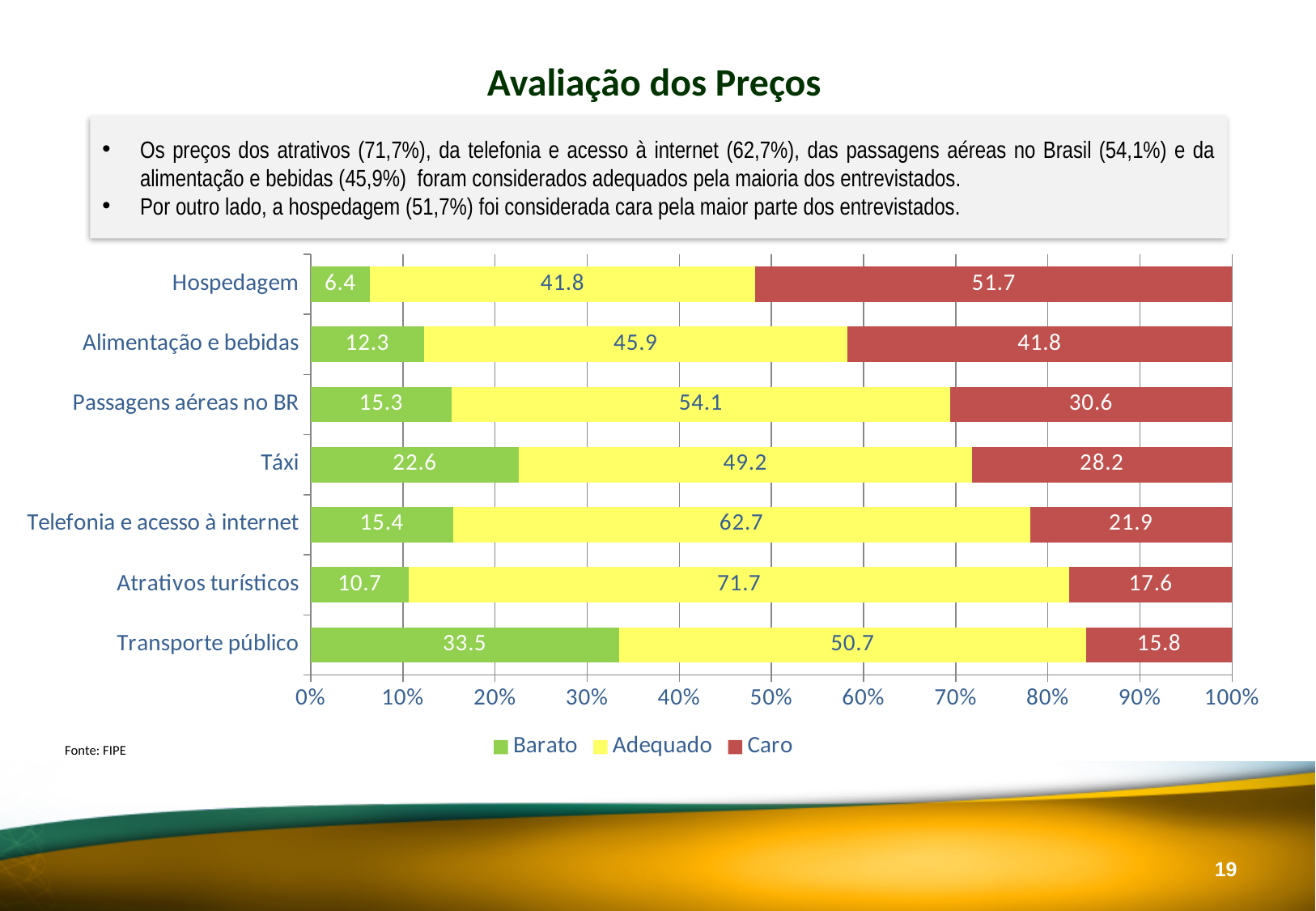
Which has the larger Barato value, Táxi or Passagens aéreas no BR? Táxi What is the value of the Barato series for Transporte público? 33.5 Which category has the lowest Barato value? Hospedagem Which category has the highest Caro value? Hospedagem Which category has the highest Adequado value? Atrativos turísticos What is the difference between the Caro value for Hospedagem and the Caro value for Transporte público? 35.9 What is the value of the Caro series for Hospedagem? 51.7 What kind of chart is shown on the slide? Stacked bar chart What are the three series listed in the legend? Barato, Adequado, Caro How many categories are shown on the chart? 7 How many series does the legend list? 3 What is the value of the Adequado series for Atrativos turísticos? 71.7